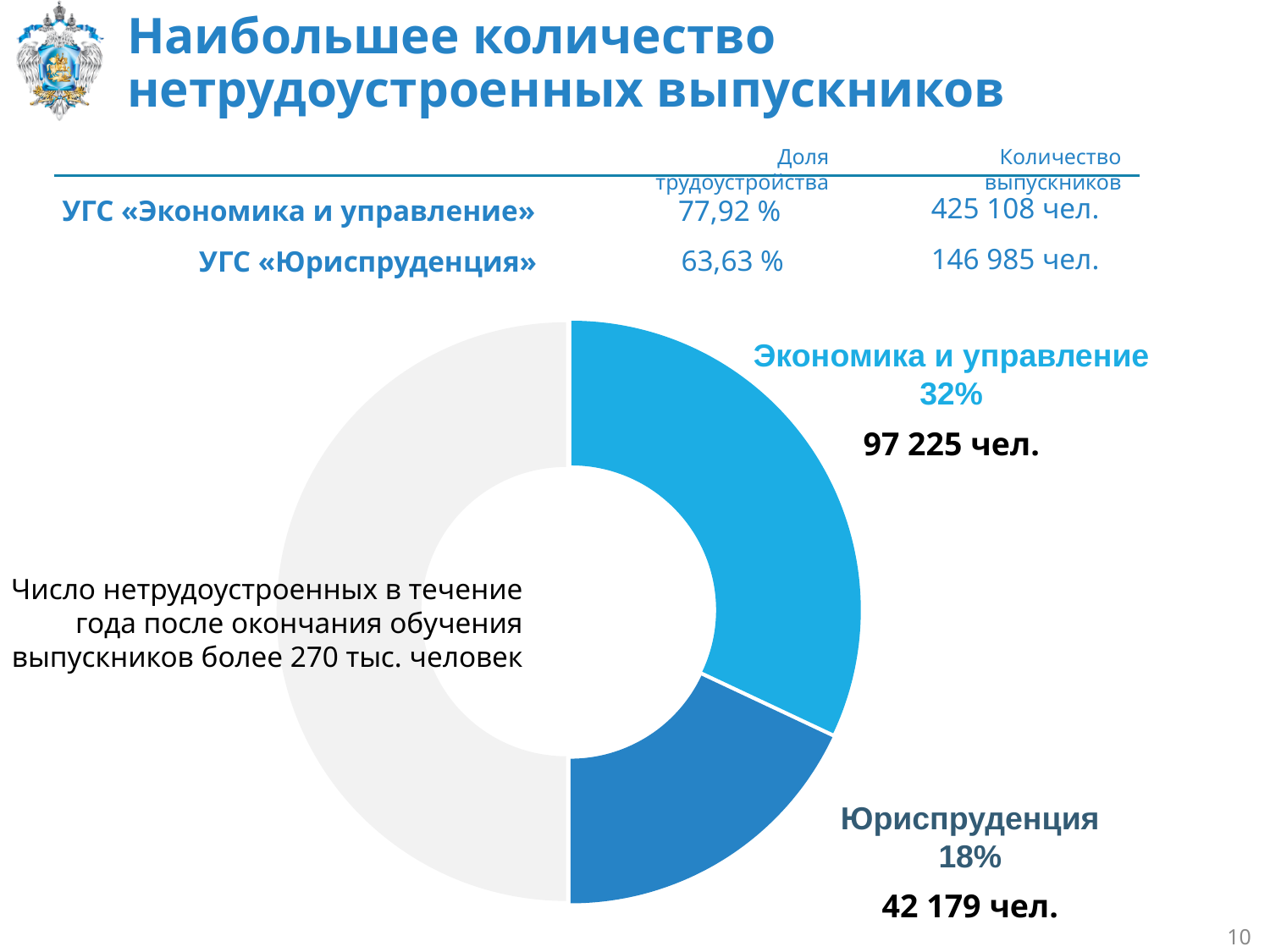
What is the combined number of people in the two labelled slices? 139 404 чел. How many people does the "Юриспруденция" slice correspond to? 42 179 чел. What share of the pie does the slice "Экономика и управление" represent? 32% What colour is the "Юриспруденция" slice? Dark blue What is the difference in people between the "Экономика и управление" and "Юриспруденция" slices? 55 046 чел. How many labelled slices does the donut chart have? 2 What share of the pie does the slice "Юриспруденция" represent? 18% By how many percentage points does the "Экономика и управление" share exceed the "Юриспруденция" share? 14 percentage points How many people does the "Экономика и управление" slice correspond to? 97 225 чел. Which labelled slice is larger, "Экономика и управление" or "Юриспруденция"? Экономика и управление Which of the labelled slices has the smallest share? Юриспруденция What kind of chart is shown on the slide? Pie (donut) chart